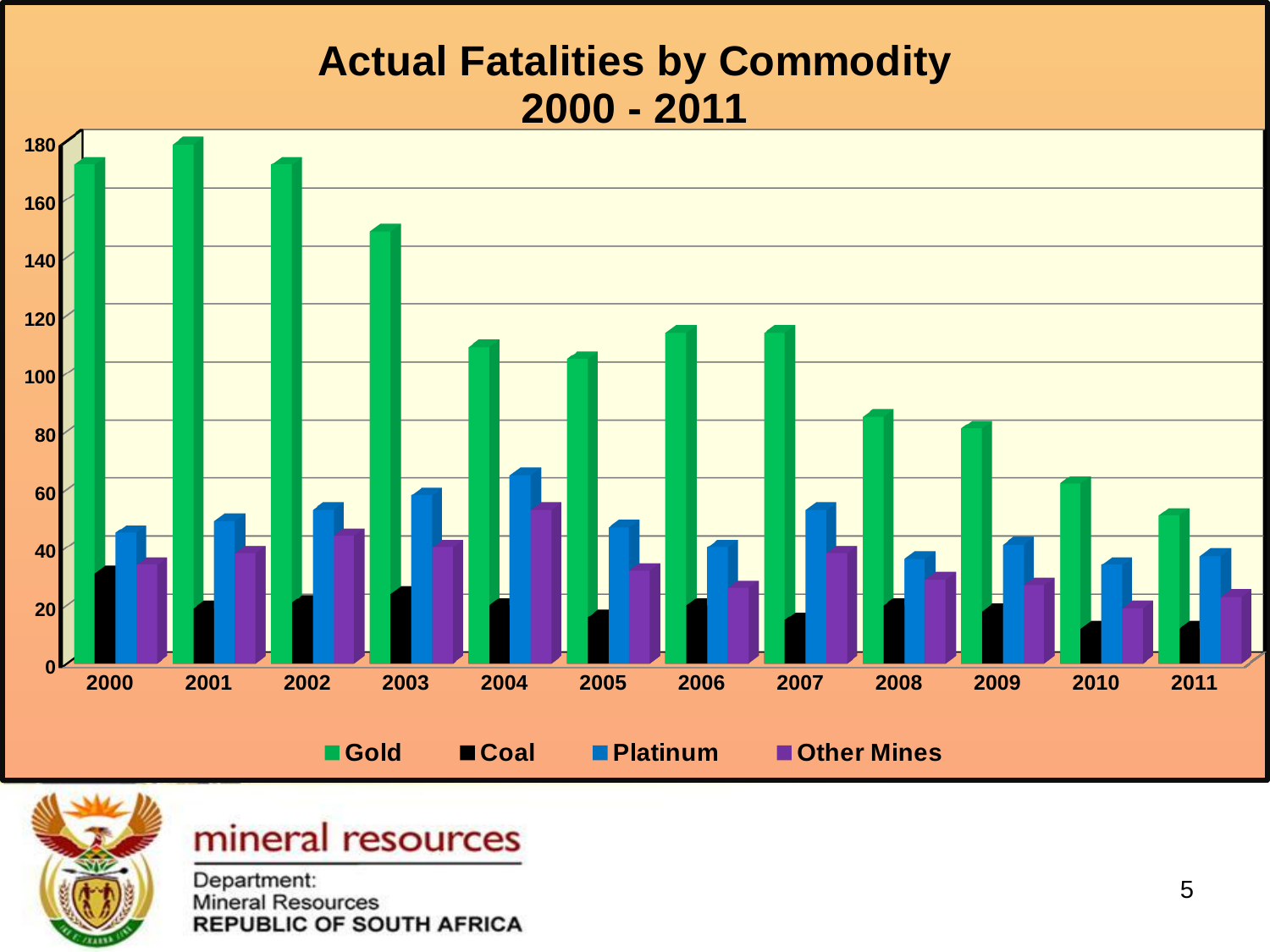
Is the value for Platinum in 2004 greater or less than 60? greater In which year were Gold fatalities lowest? 2011 In 2006, which is larger: Platinum or Other Mines? Platinum In which year were Platinum fatalities highest? 2004 In which year were Gold fatalities highest? 2001 Do Gold fatalities generally rise or fall from 2000 to 2011? Fall What kind of chart is shown on the slide? Bar chart Is the value for Coal in 2010 greater or less than 20? less Is the value for Gold in 2000 greater or less than 160? greater How many years are shown on the x axis? 12 How many series does the legend list? 4 What is the title of the chart? Actual Fatalities by Commodity 2000 - 2011